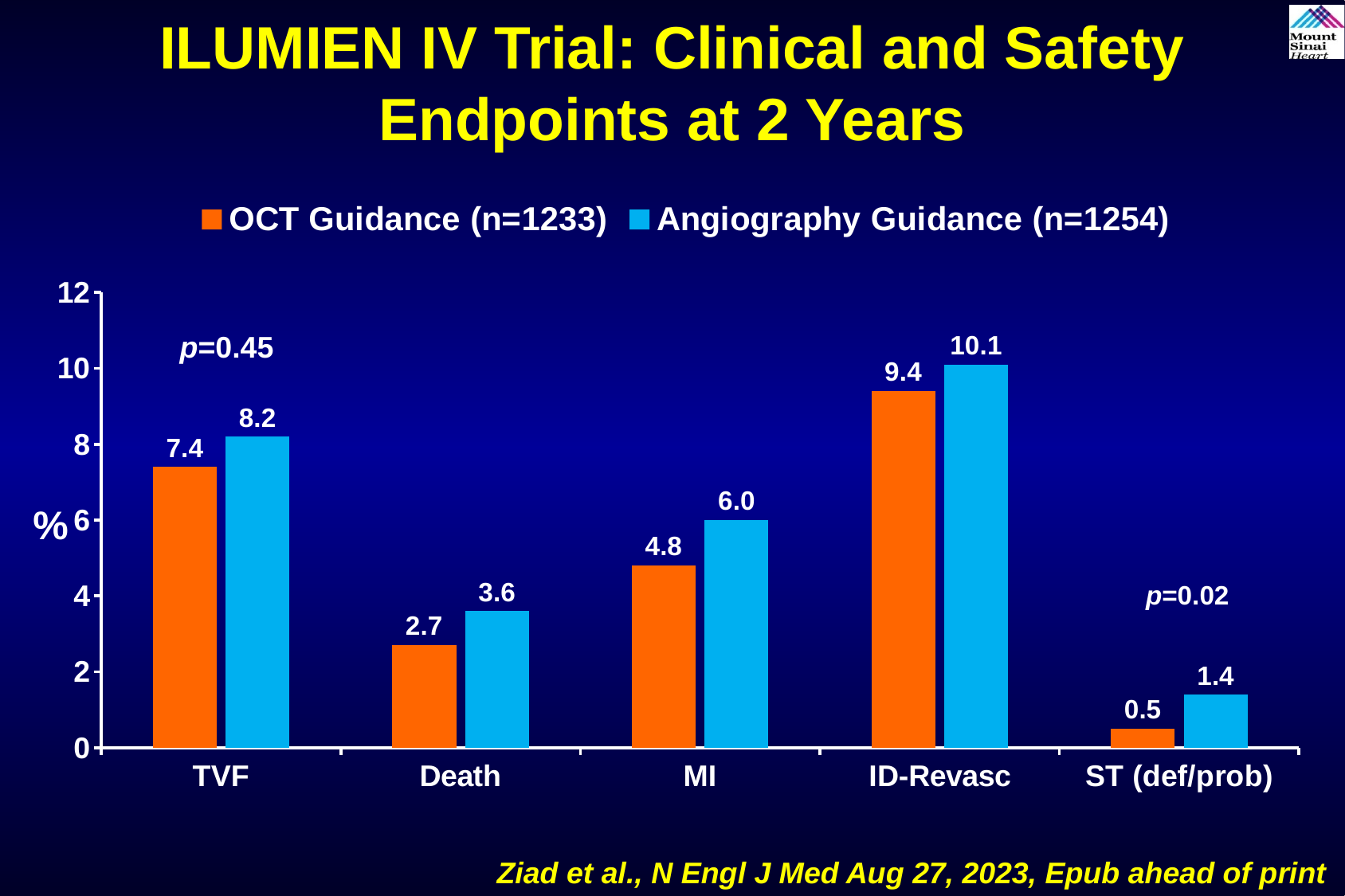
What is the difference between the Angiography Guidance and OCT Guidance values for MI? 1.2 What is the ST (def/prob) value for OCT Guidance? 0.5 What colour are the Angiography Guidance bars? Blue Which category has the highest value for Angiography Guidance? ID-Revasc How many endpoint categories are shown on the x axis? 5 What is the ID-Revasc value for Angiography Guidance? 10.1 What is the TVF value for OCT Guidance? 7.4 For Death, which series has the larger value, OCT Guidance or Angiography Guidance? Angiography Guidance Which category has the lowest value for OCT Guidance? ST (def/prob) What kind of chart is shown on the slide? Bar chart How many series does the legend list? 2 What p-value is shown above the TVF bars? p=0.45